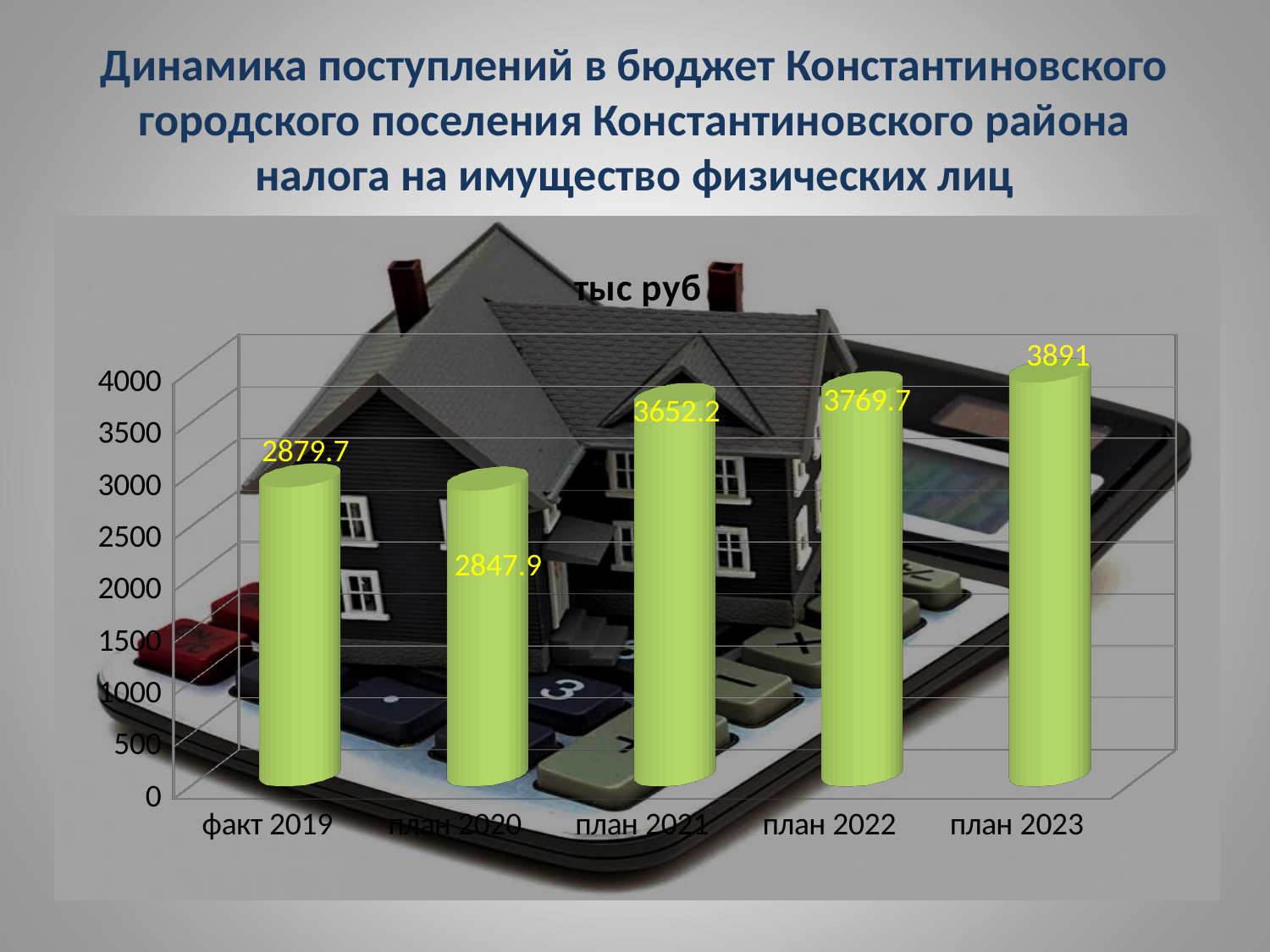
What kind of chart is shown on the slide? bar chart Is the value for план 2020 greater or less than 3000? less What is the difference between the values for план 2021 and план 2020? 804.3 How many categories are shown on the x axis? 5 Which is larger, the value for план 2022 or the value for план 2021? план 2022 What is the value for план 2023? 3891 Which category has the lowest value? план 2020 What is the value for факт 2019? 2879.7 What is the value for план 2021? 3652.2 What is the difference between the values for план 2023 and план 2022? 121.3 Which category has the highest value? план 2023 Do the values rise or fall from план 2020 to план 2023? rise